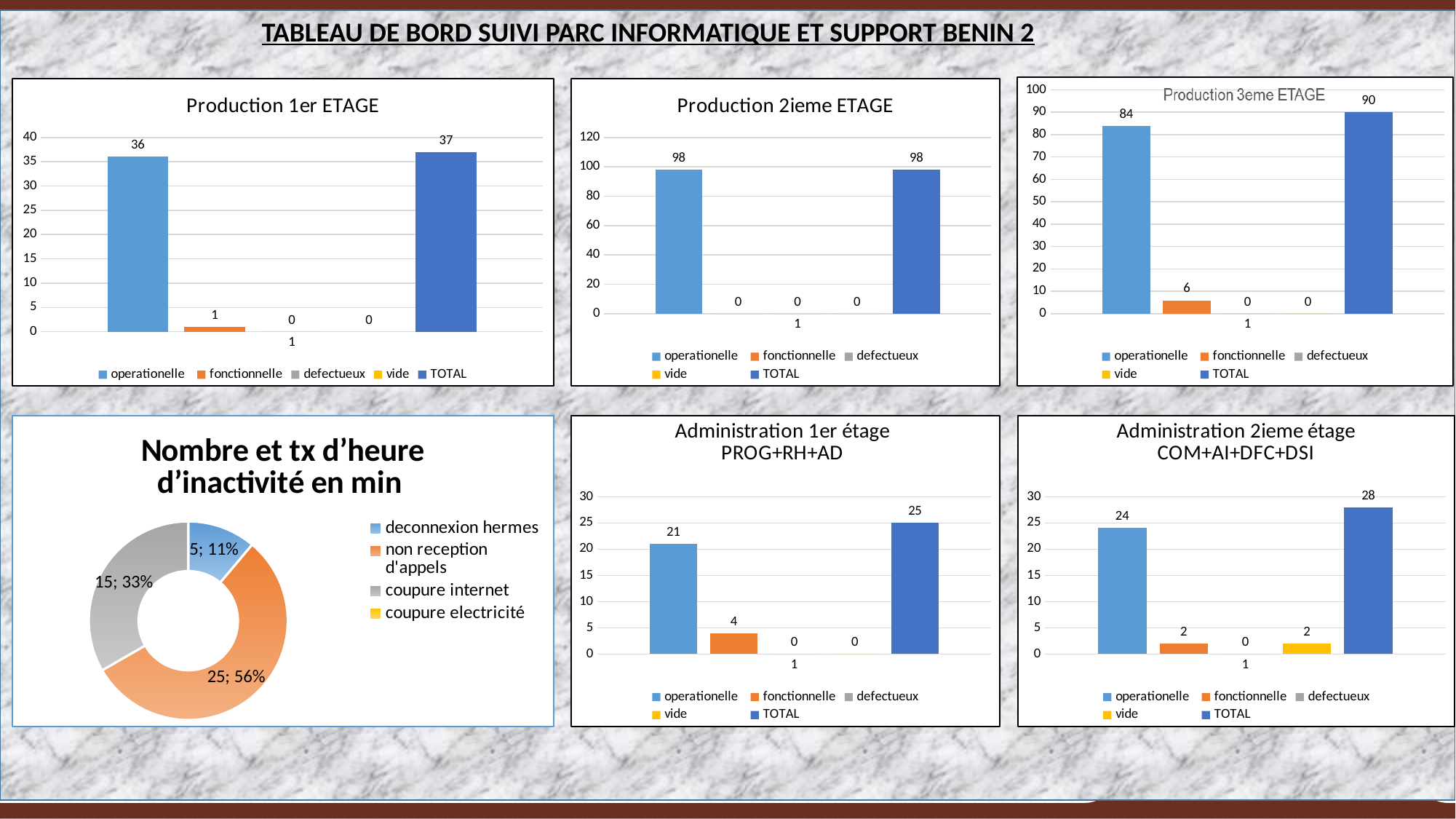
In the 'Administration 1er étage PROG+RH+AD' chart, what is the value for fonctionnelle? 4 In the 'Production 2ieme ETAGE' chart, what is the value for operationelle? 98 In the 'Administration 1er étage PROG+RH+AD' chart, which series has the lowest value? defectueux and vide (both 0) In the donut chart 'Nombre et tx d'heure d'inactivité en min', what share does 'non reception d'appels' have? 56% In the 'Administration 2ieme étage COM+AI+DFC+DSI' chart, which is larger: operationelle or TOTAL? TOTAL In the 'Production 1er ETAGE' chart, what is the TOTAL value? 37 In the donut chart 'Nombre et tx d'heure d'inactivité en min', what is the value for 'coupure internet'? 15 In the 'Production 3eme ETAGE' chart, what is the difference between TOTAL and operationelle? 6 In the 'Administration 2ieme étage COM+AI+DFC+DSI' chart, what is the value for vide? 2 In the 'Production 3eme ETAGE' chart, what is the value for fonctionnelle? 6 In the 'Production 1er ETAGE' chart, what is the value for operationelle? 36 How many series does the legend of the 'Production 2ieme ETAGE' chart list? 5